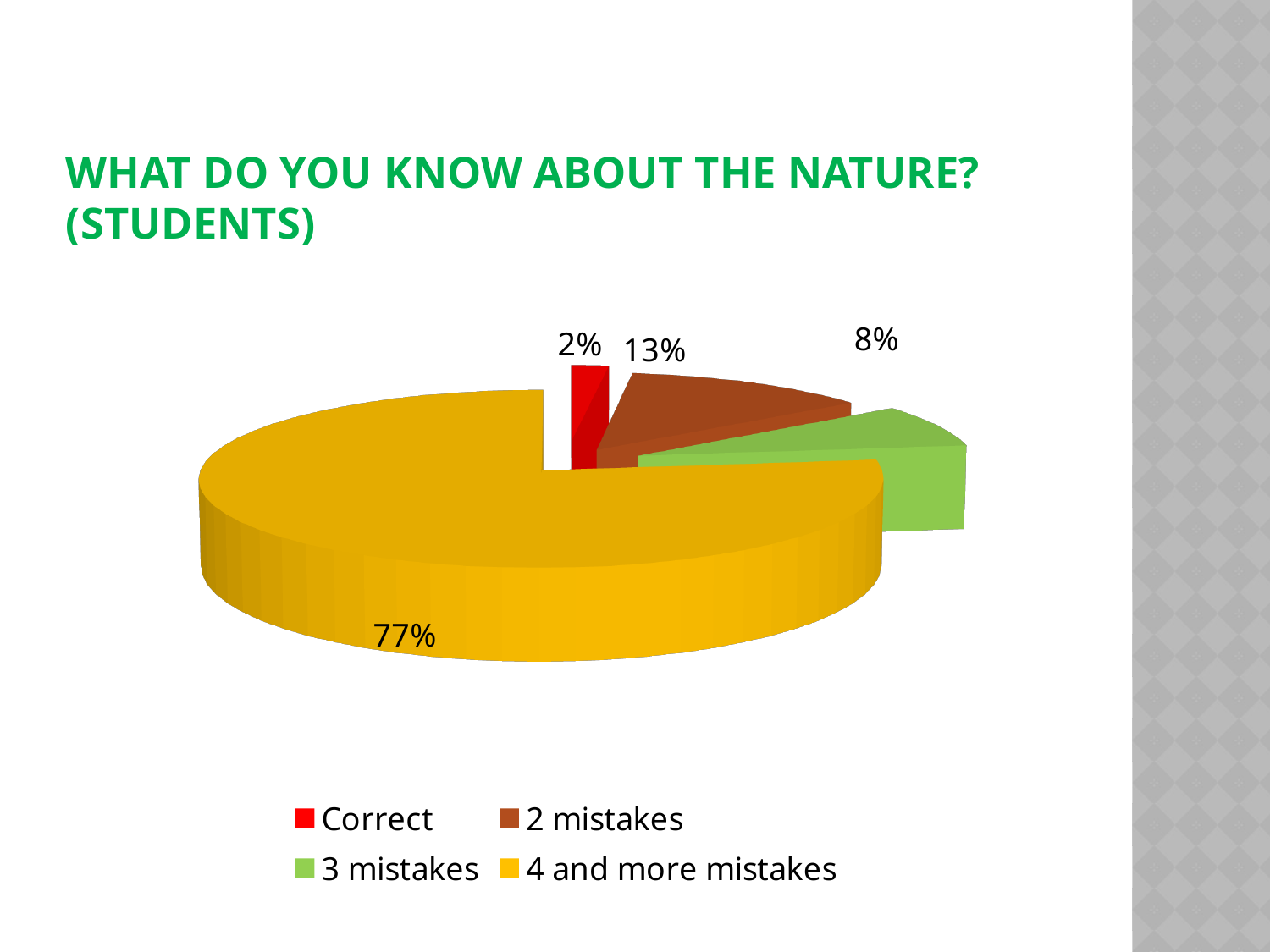
What share of the pie is labelled for "4 and more mistakes"? 77% Which category has the largest slice of the pie? 4 and more mistakes Which slice is larger: "2 mistakes" or "3 mistakes"? 2 mistakes What percentage is shown for the "2 mistakes" slice? 13% How many slices does the pie chart have? 4 What percentage is shown for the "Correct" slice? 2% Which category has the smallest slice of the pie? Correct What percentage is shown for the "3 mistakes" slice? 8% What colour is the "3 mistakes" slice? Green What is the title of the slide containing the chart? What do you know about the nature? (Students) What is the difference in percentage points between "2 mistakes" and "3 mistakes"? 5 What kind of chart is shown on the slide? Pie chart